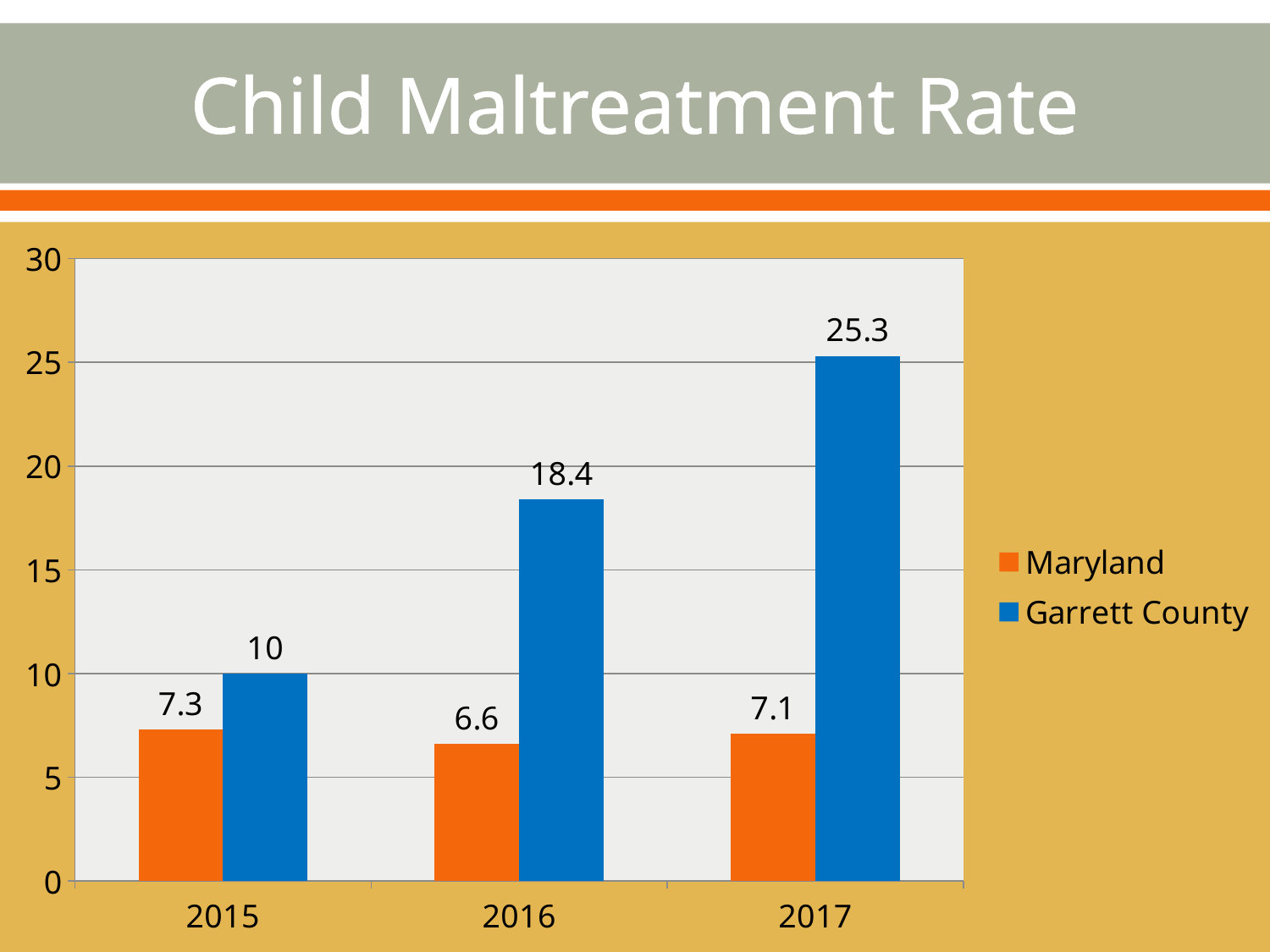
What is the difference between the Garrett County and Maryland rates in 2017? 18.2 What is the Maryland child maltreatment rate in 2016? 6.6 Which is larger in 2015, the Maryland rate or the Garrett County rate? Garrett County In which year is the Garrett County rate highest? 2017 What is the Garrett County child maltreatment rate in 2017? 25.3 In which year is the Maryland rate lowest? 2016 What kind of chart is shown on the slide? Bar chart How many years are shown on the x axis? 3 By how much did the Garrett County rate increase from 2016 to 2017? 6.9 What is the Garrett County value for 2015? 10 Does the Garrett County rate rise or fall from 2015 to 2017? Rise How many series does the legend list? 2